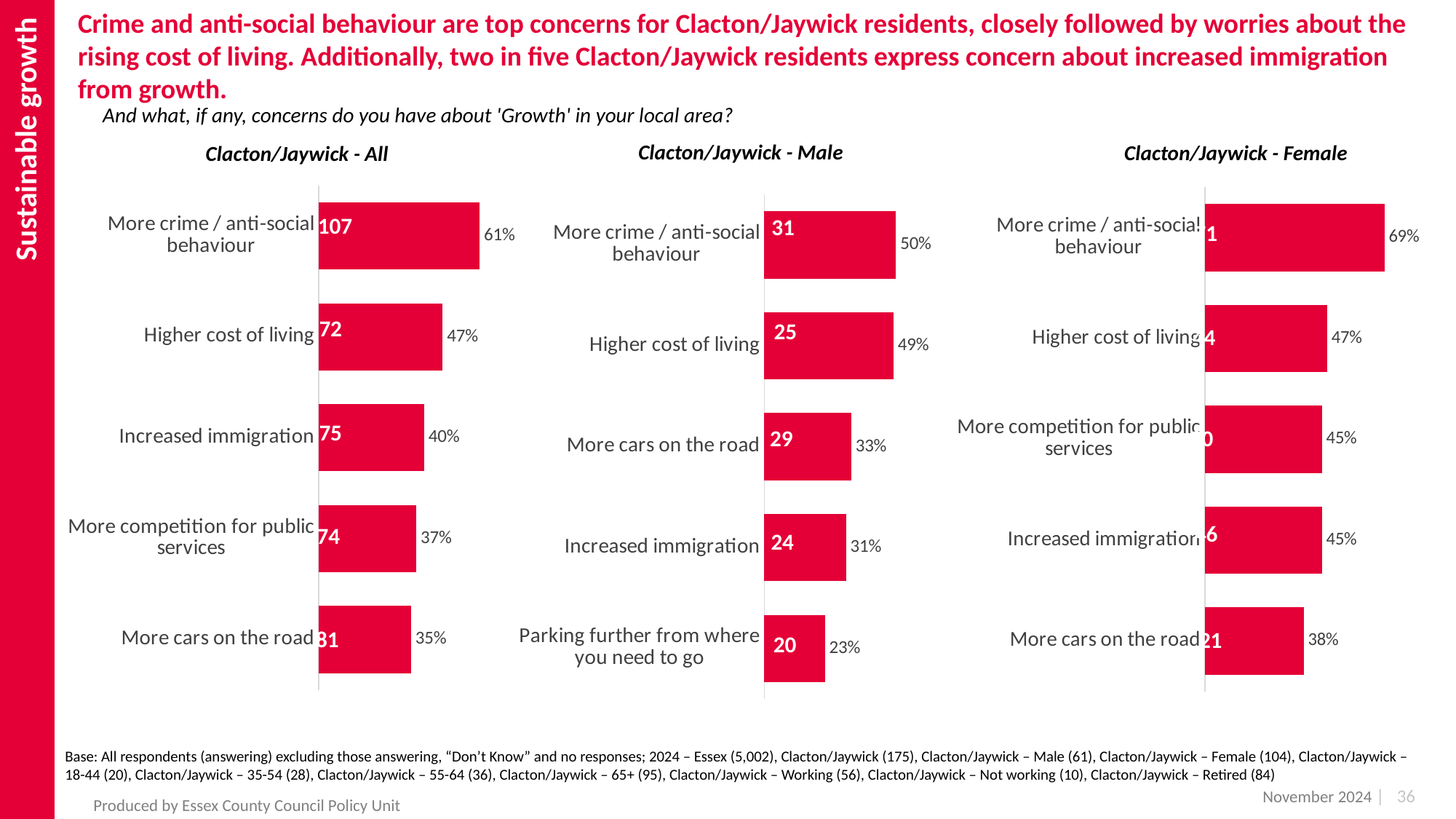
Which is larger: the percentage for 'More crime / anti-social behaviour' in the 'Clacton/Jaywick - Male' chart or in the 'Clacton/Jaywick - Female' chart? Clacton/Jaywick - Female In the 'Clacton/Jaywick - All' chart, what is the difference in percentage points between 'More crime / anti-social behaviour' and 'Higher cost of living'? 14 percentage points In the 'Clacton/Jaywick - All' chart, what percentage is shown for 'More crime / anti-social behaviour'? 61% In the 'Clacton/Jaywick - Male' chart, what percentage is shown for 'Parking further from where you need to go'? 23% In the 'Clacton/Jaywick - All' chart, what percentage is shown for 'Increased immigration'? 40% How many concerns are listed in the 'Clacton/Jaywick - Male' chart? 5 In the 'Clacton/Jaywick - Female' chart, which concern has the highest percentage? More crime / anti-social behaviour In the 'Clacton/Jaywick - Male' chart, what count is printed on the bar for 'Higher cost of living'? 25 In the 'Clacton/Jaywick - Female' chart, what percentage is shown for 'More cars on the road'? 38% What type of chart is used for 'Clacton/Jaywick - All'? Bar chart How many charts are shown on the slide? 3 In the 'Clacton/Jaywick - Male' chart, which concern has the lowest percentage? Parking further from where you need to go